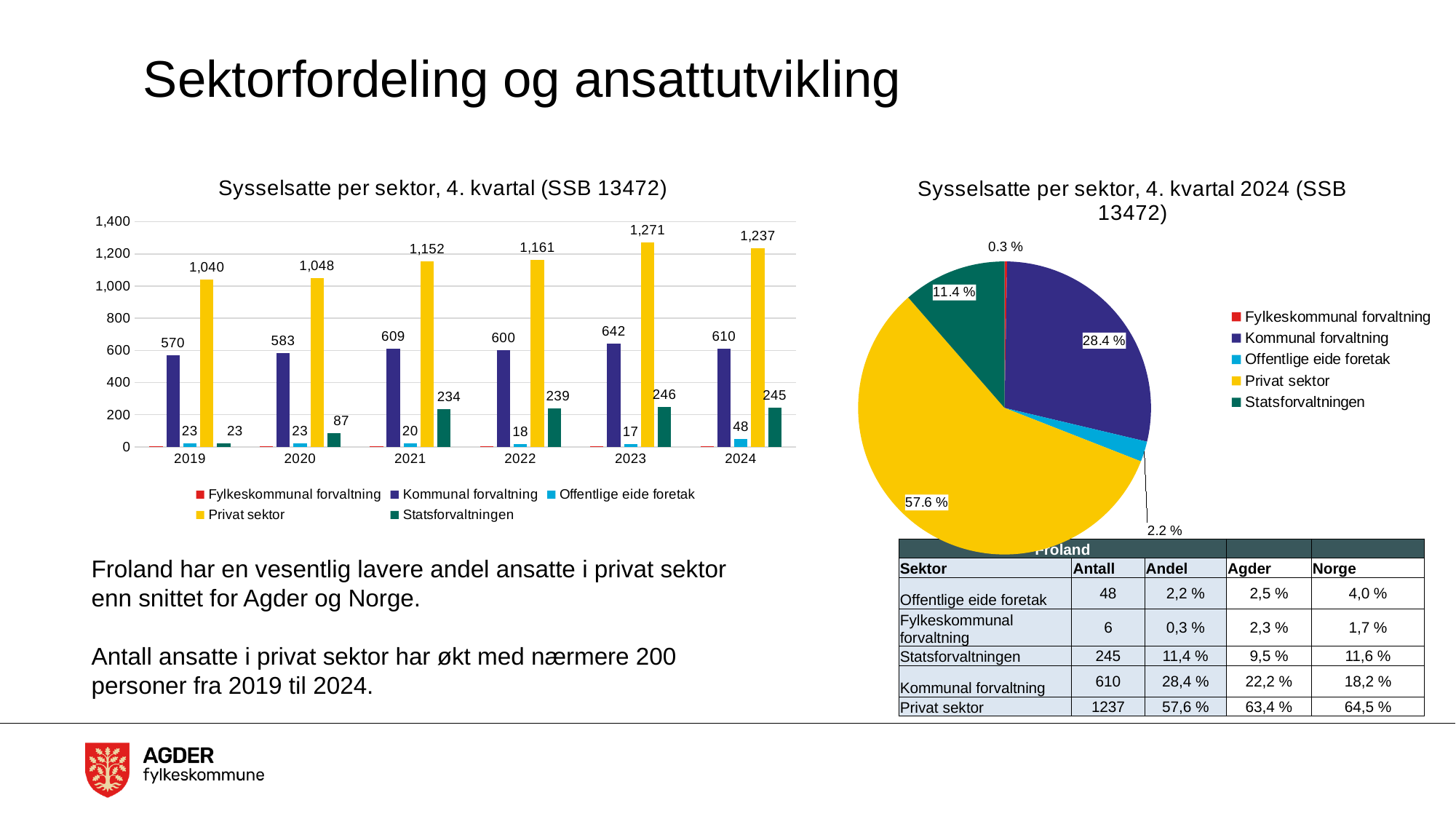
In the bar chart 'Sysselsatte per sektor, 4. kvartal (SSB 13472)', what is the value for Privat sektor in 2023? 1,271 In the bar chart 'Sysselsatte per sektor, 4. kvartal (SSB 13472)', in which year is the Privat sektor value highest? 2023 In the bar chart 'Sysselsatte per sektor, 4. kvartal (SSB 13472)', what is the value for Kommunal forvaltning in 2019? 570 In the bar chart 'Sysselsatte per sektor, 4. kvartal (SSB 13472)', how many series does the legend list? 5 In the pie chart 'Sysselsatte per sektor, 4. kvartal 2024 (SSB 13472)', what share does Privat sektor have? 57.6 % In the bar chart 'Sysselsatte per sektor, 4. kvartal (SSB 13472)', what is the difference between the Privat sektor values for 2024 and 2019? 197 What kind of chart is the chart on the left of the slide? Bar chart In the bar chart 'Sysselsatte per sektor, 4. kvartal (SSB 13472)', which is larger: Kommunal forvaltning in 2021 or in 2022? 2021 In the pie chart 'Sysselsatte per sektor, 4. kvartal 2024 (SSB 13472)', what share does Statsforvaltningen have? 11.4 % In the bar chart 'Sysselsatte per sektor, 4. kvartal (SSB 13472)', what is the value for Statsforvaltningen in 2020? 87 In the bar chart 'Sysselsatte per sektor, 4. kvartal (SSB 13472)', in which year is the Offentlige eide foretak value lowest? 2023 In the bar chart 'Sysselsatte per sektor, 4. kvartal (SSB 13472)', how many years are shown on the x axis? 6